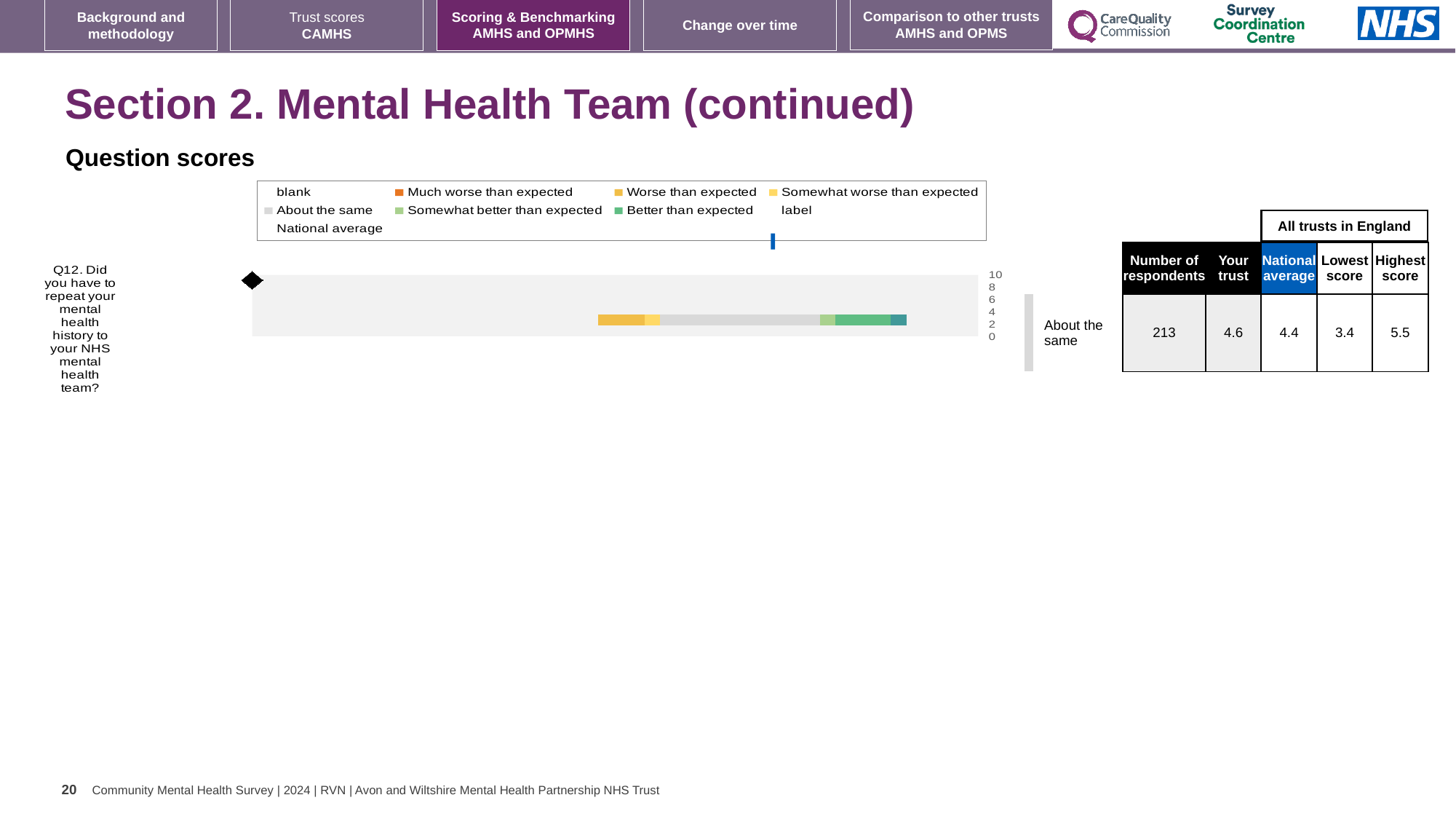
What is the highest score among all trusts in England for Q12? 5.5 For Q12, which is higher: the 'Your trust' score or the national average? Your trust What is the 'Your trust' score for Q12 in the table beside the chart? 4.6 For Q12, what is the difference between the highest score and the lowest score among all trusts in England? 2.1 What is the lowest score among all trusts in England for Q12? 3.4 Which question is plotted in the chart? Q12. Did you have to repeat your mental health history to your NHS mental health team? What is the national average score for Q12 in the table beside the chart? 4.4 What benchmark category is shown to the right of the bar for Q12? About the same What kind of chart is shown on the slide? bar chart For Q12, how much higher is the 'Your trust' score than the national average? 0.2 How many survey questions are plotted in the chart? 1 How many respondents answered Q12? 213